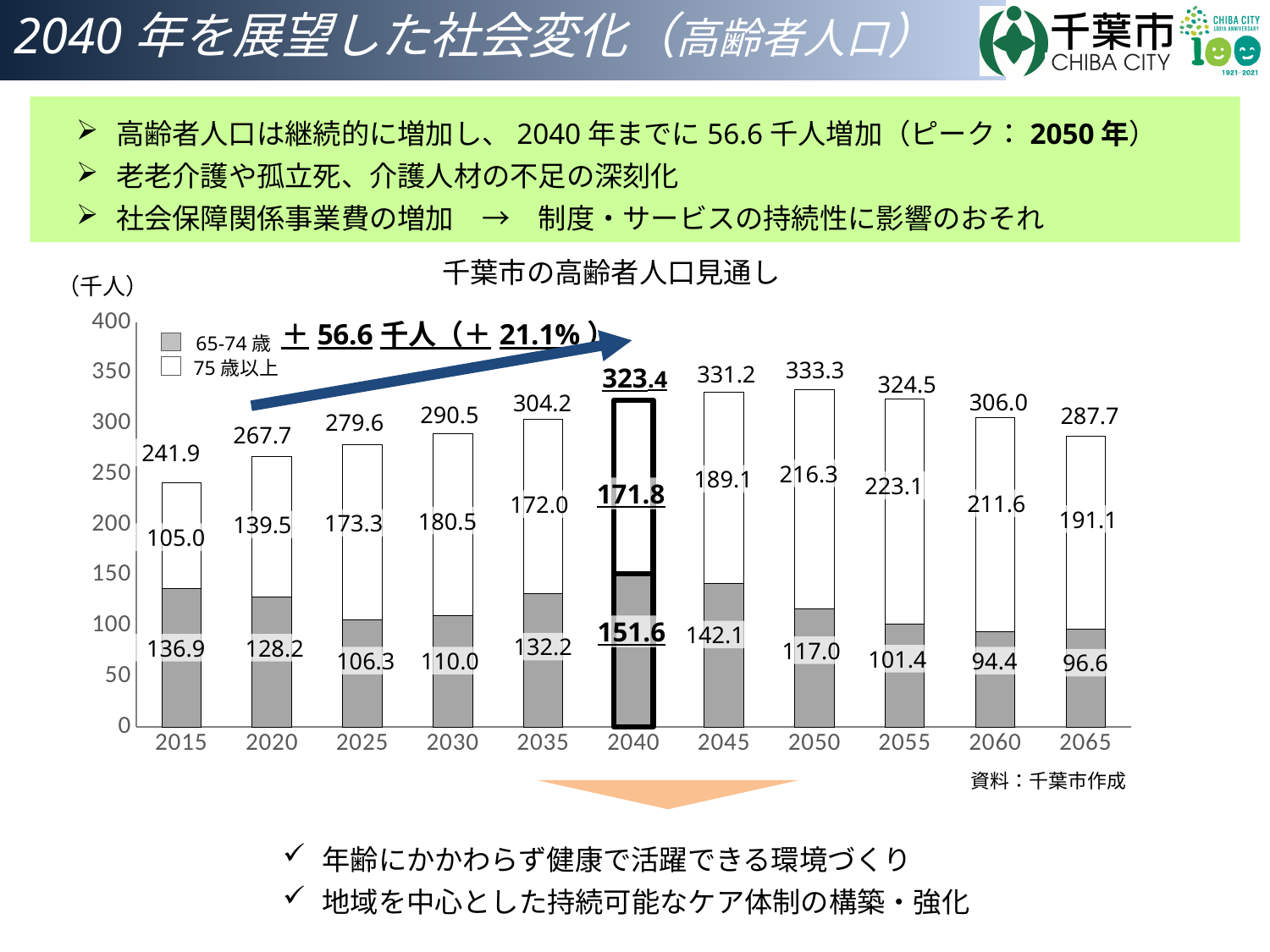
What is the value for 65-74歳 in 2015? 136.9 What is the difference between the total for 2040 and the total for 2015? 81.5 Which year has the lowest total elderly population? 2015 What is the value for 75歳以上 in 2055? 223.1 Which year has the highest total elderly population? 2050 How many series does the legend list? 2 Which year has the highest value for 65-74歳? 2040 What is the total elderly population (千人) shown for 2040? 323.4 What is the title of the chart? 千葉市の高齢者人口見通し What type of chart is shown on the slide? Stacked bar chart Which is larger, the 75歳以上 value in 2050 or in 2060? 2050 How many years are shown on the x axis? 11